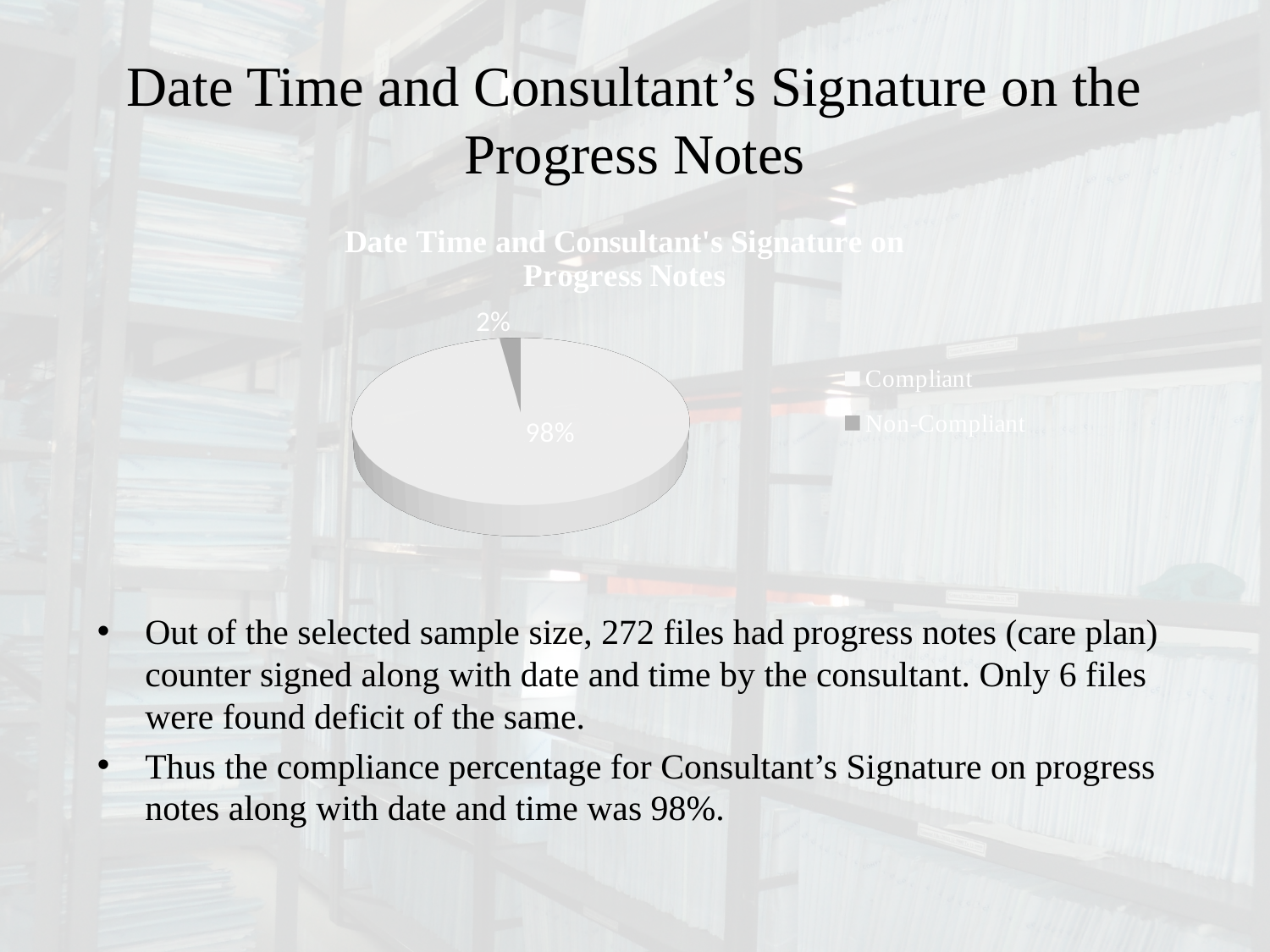
What is the title of the chart? Date Time and Consultant's Signature on Progress Notes How many slices does the pie chart have? 2 What share of the pie does the Compliant slice represent? 98% Which category has the smallest share of the pie? Non-Compliant What is the difference in percentage points between the Compliant and Non-Compliant slices? 96 How many categories does the legend list? 2 What kind of chart is shown on the slide? Pie chart What percentage of the pie is labelled for the Non-Compliant slice? 2% What percentage of the pie is labelled for the Compliant slice? 98% Which is larger, the Compliant slice or the Non-Compliant slice? Compliant Which category has the largest share of the pie? Compliant